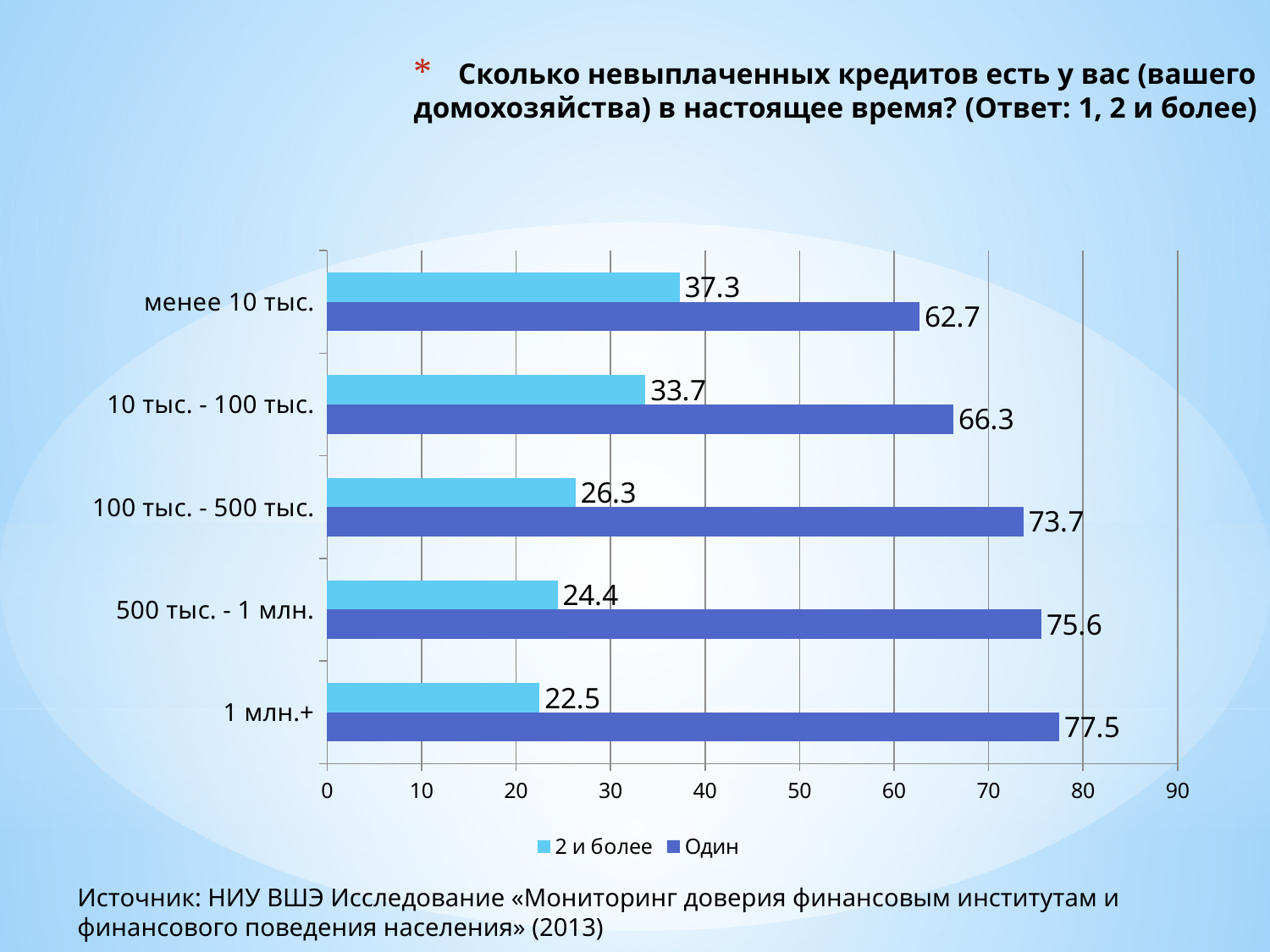
Which category has the highest value for "2 и более"? менее 10 тыс. Which is larger in the "10 тыс. - 100 тыс." category: "Один" or "2 и более"? Один How many series does the legend list? 2 What is the value for "Один" in the "100 тыс. - 500 тыс." category? 73.7 What is the difference between the "Один" and "2 и более" values in the "500 тыс. - 1 млн." category? 51.2 How many categories are shown on the chart? 5 What is the total of the "Один" and "2 и более" values for the "менее 10 тыс." category? 100 Which category has the lowest value for "Один"? менее 10 тыс. Is the value for "2 и более" in the "1 млн.+" category greater or less than 30? less What kind of chart is shown on the slide? bar chart What is the value for "2 и более" in the "менее 10 тыс." category? 37.3 What is the value for "Один" in the "1 млн.+" category? 77.5